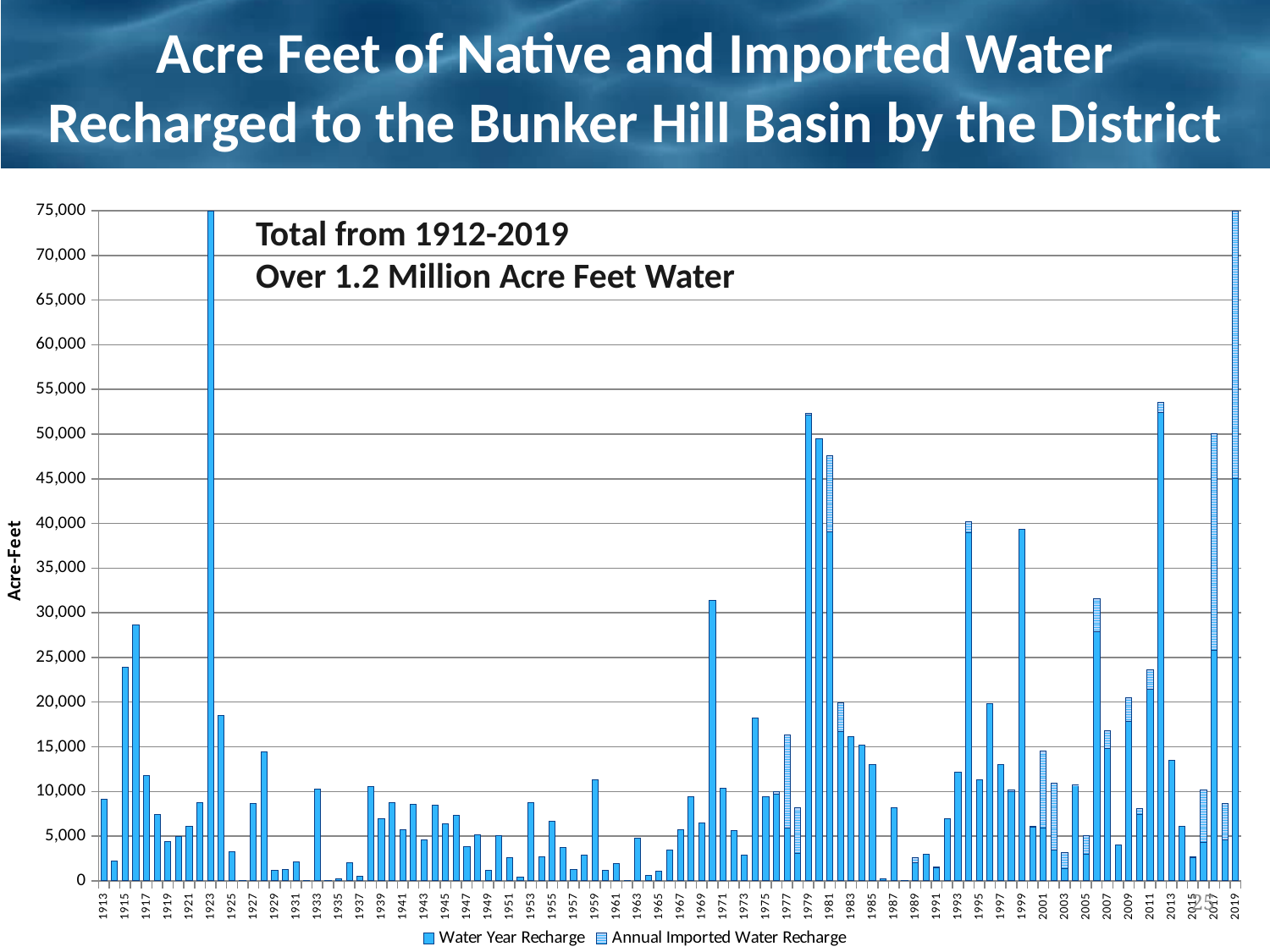
Is the value for 2013 greater or less than 15,000? less What kind of chart is shown on the slide? Bar chart Which year has the larger total, 1979 or 1969? 1979 Is the value for 2011 greater or less than 20,000? greater Is the value for 1979 greater or less than 50,000? greater According to the text on the chart, what is the total recharge from 1912-2019? Over 1.2 Million Acre Feet Water How many series does the legend list? 2 What are the two series named in the legend? Water Year Recharge and Annual Imported Water Recharge Which year has the larger total, 1916 or 1915? 1916